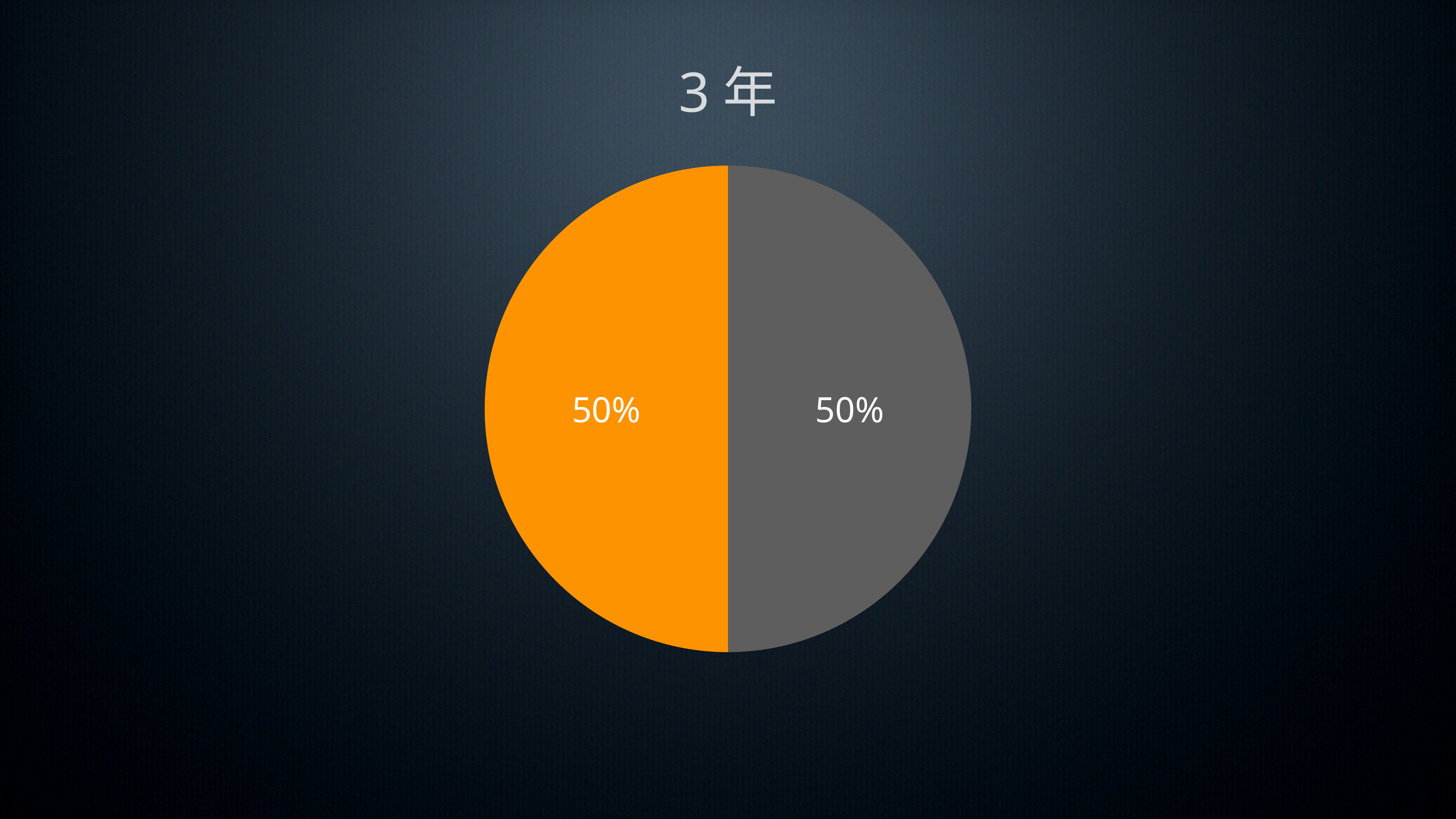
What share of the pie does the gray slice represent? 50% What do the two slice percentages add up to? 100% What is the difference between the orange slice's share and the gray slice's share? 0% How many slices does the pie chart have? 2 What is the title of the pie chart? ３年 What kind of chart is shown on the slide? pie chart Is the orange slice larger than, smaller than, or equal to the gray slice? equal What colour is the slice on the left half of the pie? orange What share of the pie does the orange slice represent? 50%